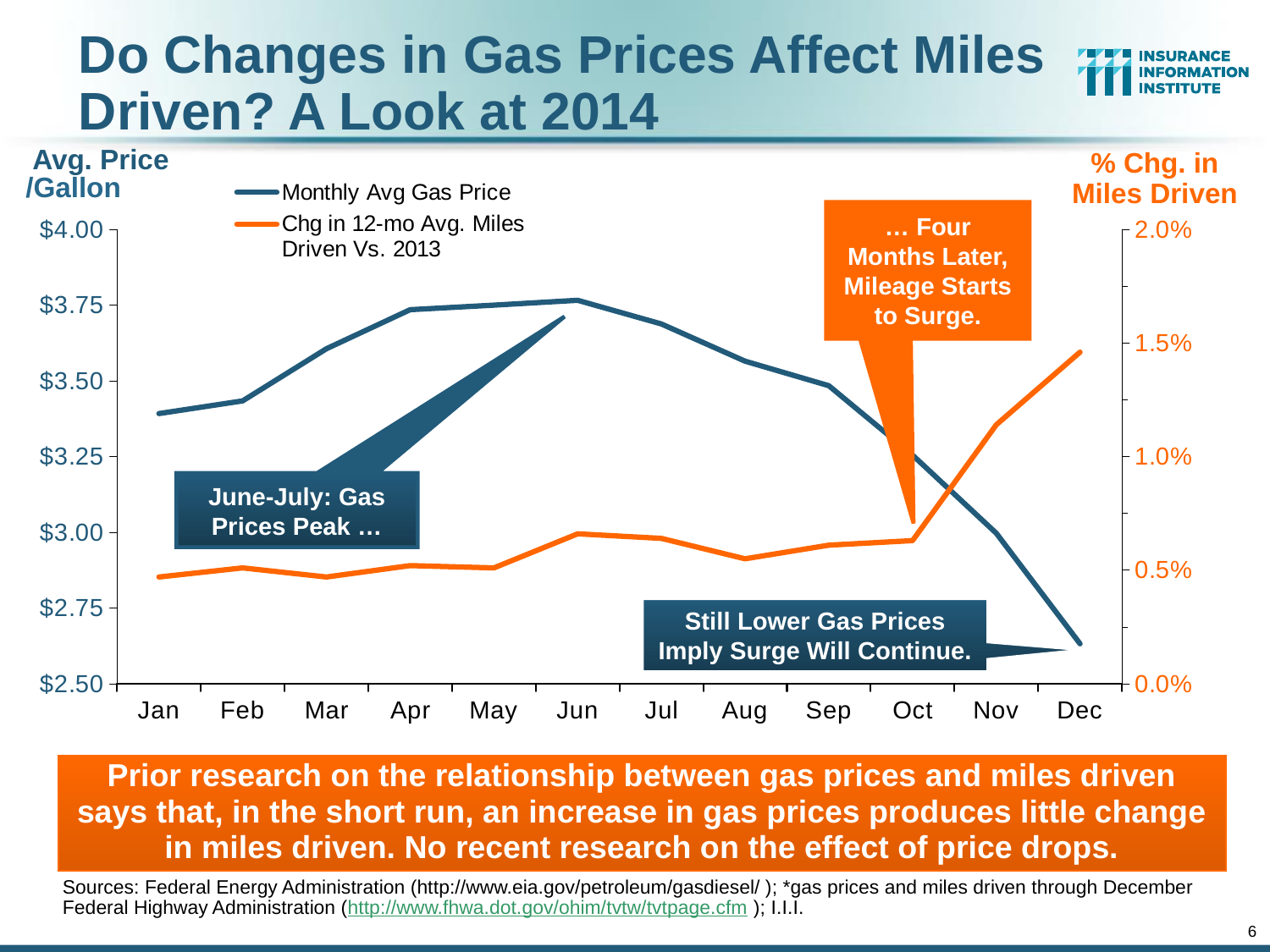
What kind of chart is shown on the slide? line chart Is the Monthly Avg Gas Price for Jan greater or less than $3.25? greater In which month is the Monthly Avg Gas Price lowest? Dec Is the Chg in 12-mo Avg. Miles Driven for Oct greater or less than 1.0%? less In which month is the Chg in 12-mo Avg. Miles Driven Vs. 2013 highest? Dec How many months are plotted along the x axis? 12 Is the Monthly Avg Gas Price for Dec greater or less than $2.75? less Which is larger, the Monthly Avg Gas Price in Jan or in Dec? Jan In which month does the Monthly Avg Gas Price reach its highest point? Jun Does the Monthly Avg Gas Price rise or fall from Jun to Dec? fall How many series does the chart's legend list? 2